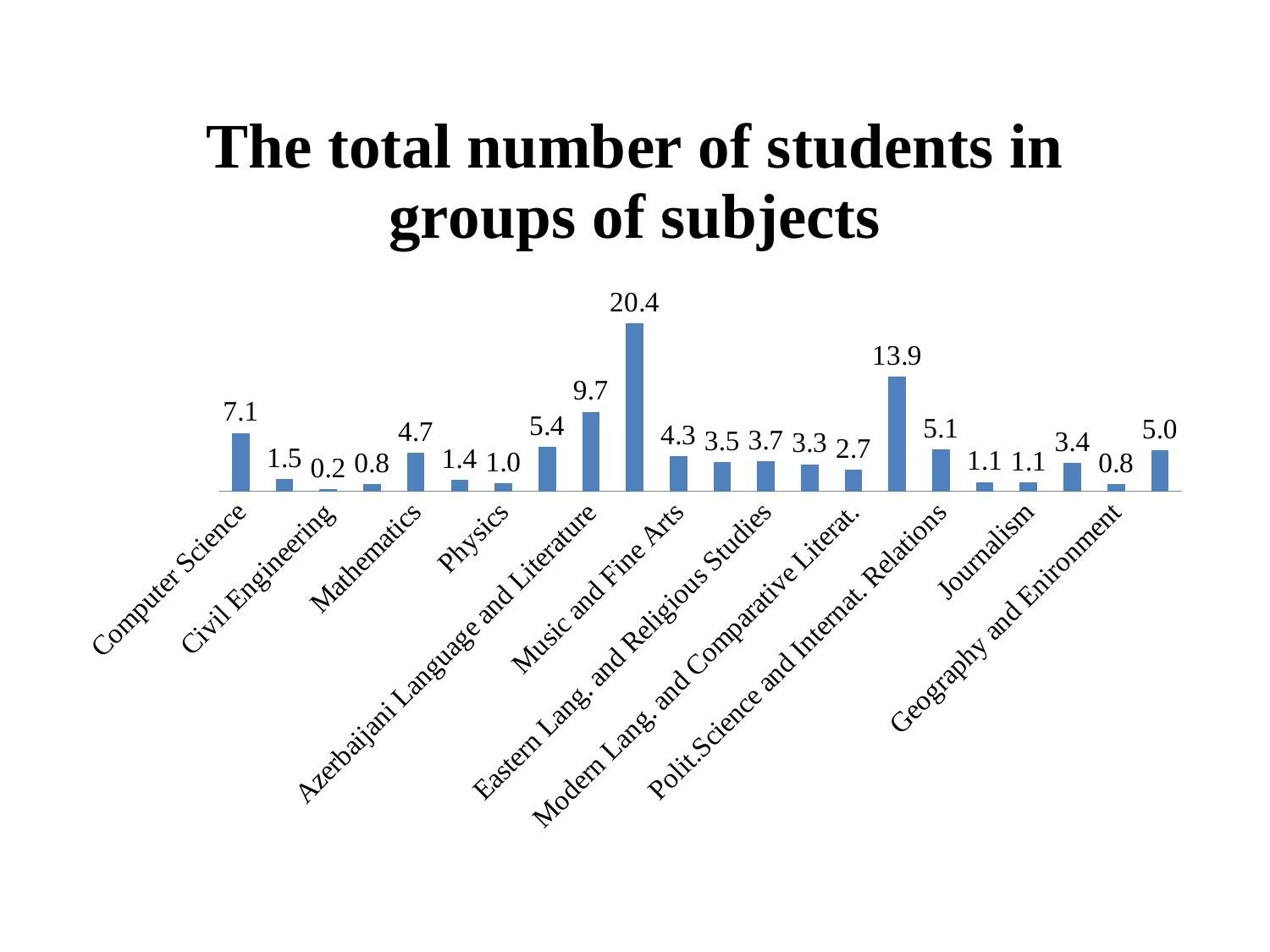
What is the difference between the highest value (20.4) and the second highest value (13.9)? 6.5 What is the second highest value shown on the chart? 13.9 What colour are the bars on the chart? blue How many bars are plotted on the chart? 22 Which is larger, the value for Computer Science (7.1) or the highest bar (20.4)? 20.4 What is the lowest value shown on the chart? 0.2 What is the highest value shown on the chart? 20.4 What is the value of the last bar on the right of the chart? 5.0 What is the value of the first bar, Computer Science? 7.1 What is the difference between the first bar (7.1) and the last bar (5.0)? 2.1 What is the title of the chart? The total number of students in groups of subjects What kind of chart is shown on the slide? bar chart